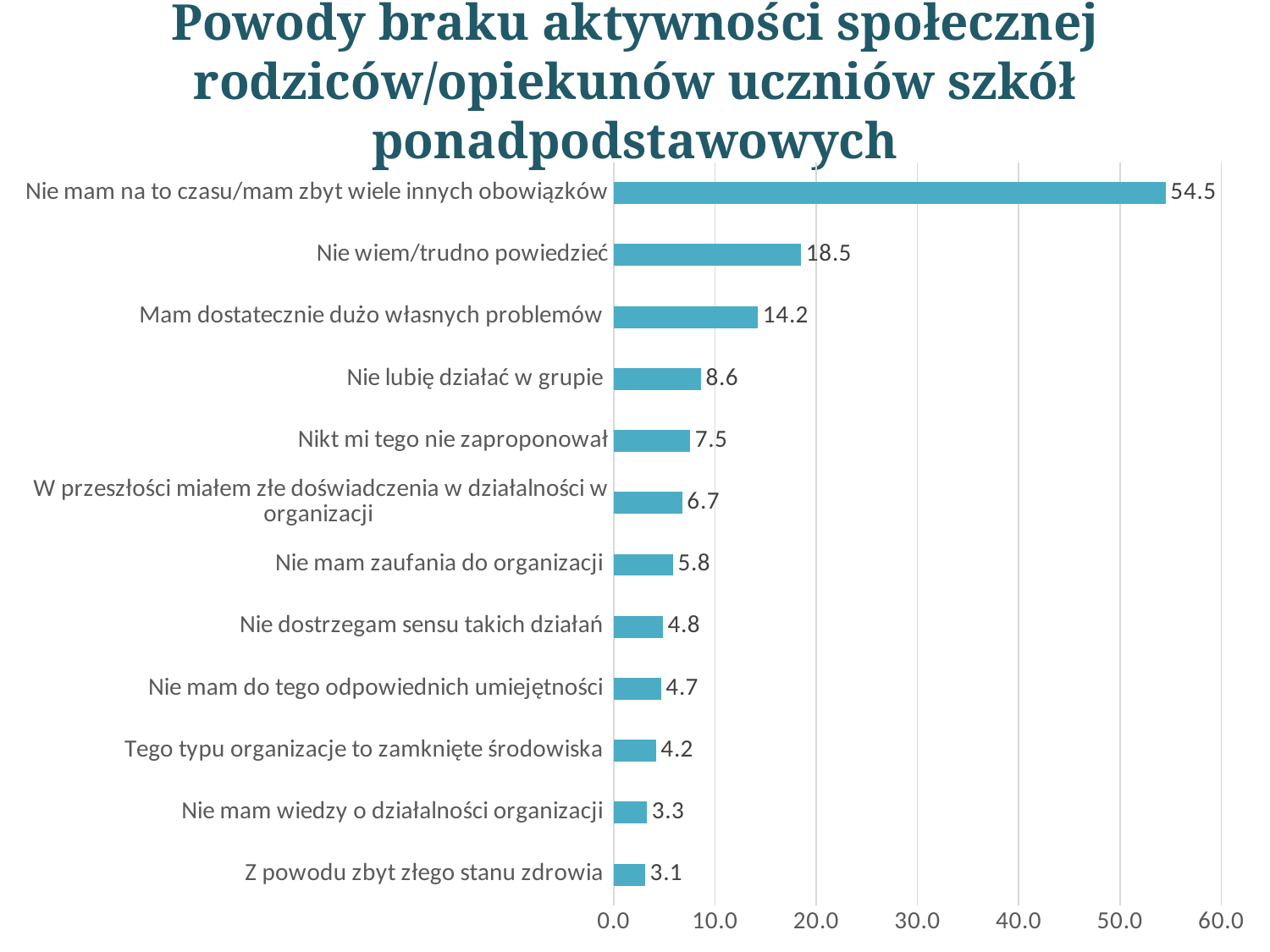
What is the value for "Nie mam na to czasu/mam zbyt wiele innych obowiązków"? 54.5 What is the difference between the values for "Nie wiem/trudno powiedzieć" and "Mam dostatecznie dużo własnych problemów"? 4.3 What is the value for "Nikt mi tego nie zaproponował"? 7.5 Is the value for "Mam dostatecznie dużo własnych problemów" greater or less than 10.0? greater How many categories are shown in the chart? 12 What is the value for "Nie mam wiedzy o działalności organizacji"? 3.3 Which category has the highest value? Nie mam na to czasu/mam zbyt wiele innych obowiązków What is the value for "Nie wiem/trudno powiedzieć"? 18.5 Which is larger: the value for "Nie lubię działać w grupie" or the value for "Nie mam zaufania do organizacji"? Nie lubię działać w grupie What kind of chart is shown on the slide? bar chart Which category has the lowest value? Z powodu zbyt złego stanu zdrowia What is the title of the chart? Powody braku aktywności społecznej rodziców/opiekunów uczniów szkół ponadpodstawowych